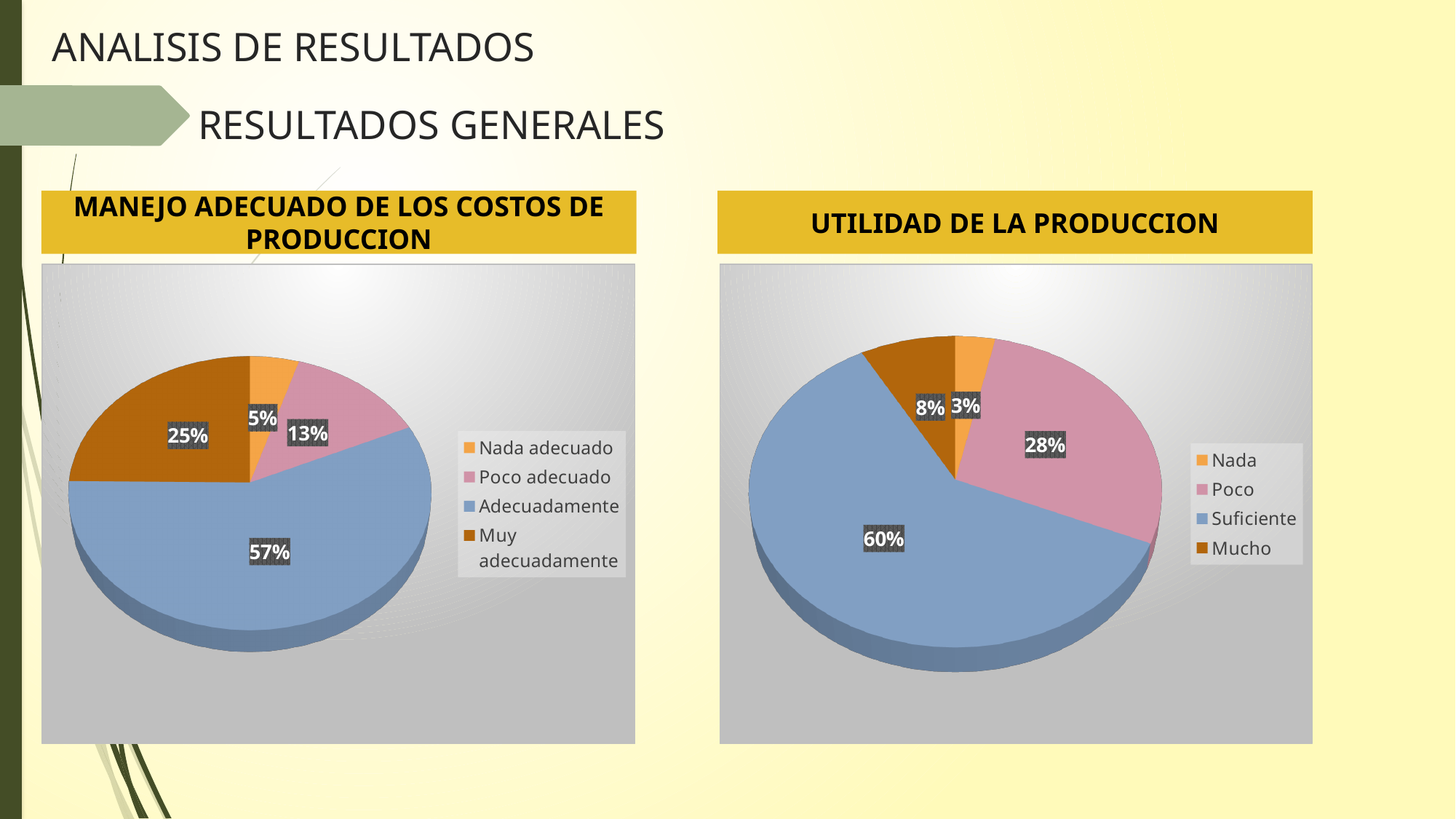
In the 'MANEJO ADECUADO DE LOS COSTOS DE PRODUCCION' chart, which category has the smallest share? Nada adecuado In the 'UTILIDAD DE LA PRODUCCION' chart, which category has the largest share? Suficiente In the 'UTILIDAD DE LA PRODUCCION' chart, what percentage is shown for 'Suficiente'? 60% In the 'UTILIDAD DE LA PRODUCCION' chart, what is the difference between the 'Poco' and 'Nada' shares? 25% In the 'UTILIDAD DE LA PRODUCCION' chart, which is larger, 'Poco' or 'Mucho'? Poco In the 'MANEJO ADECUADO DE LOS COSTOS DE PRODUCCION' chart, what colour is the 'Poco adecuado' slice? Pink In the 'MANEJO ADECUADO DE LOS COSTOS DE PRODUCCION' chart, what percentage is shown for 'Muy adecuadamente'? 25% In the 'MANEJO ADECUADO DE LOS COSTOS DE PRODUCCION' chart, how many categories does the legend list? 4 In the 'MANEJO ADECUADO DE LOS COSTOS DE PRODUCCION' chart, what is the difference between the 'Adecuadamente' and 'Muy adecuadamente' shares? 32% In the 'MANEJO ADECUADO DE LOS COSTOS DE PRODUCCION' chart, what percentage is shown for 'Adecuadamente'? 57% In the 'UTILIDAD DE LA PRODUCCION' chart, what percentage is shown for 'Mucho'? 8% What kind of chart is the 'UTILIDAD DE LA PRODUCCION' chart? Pie chart